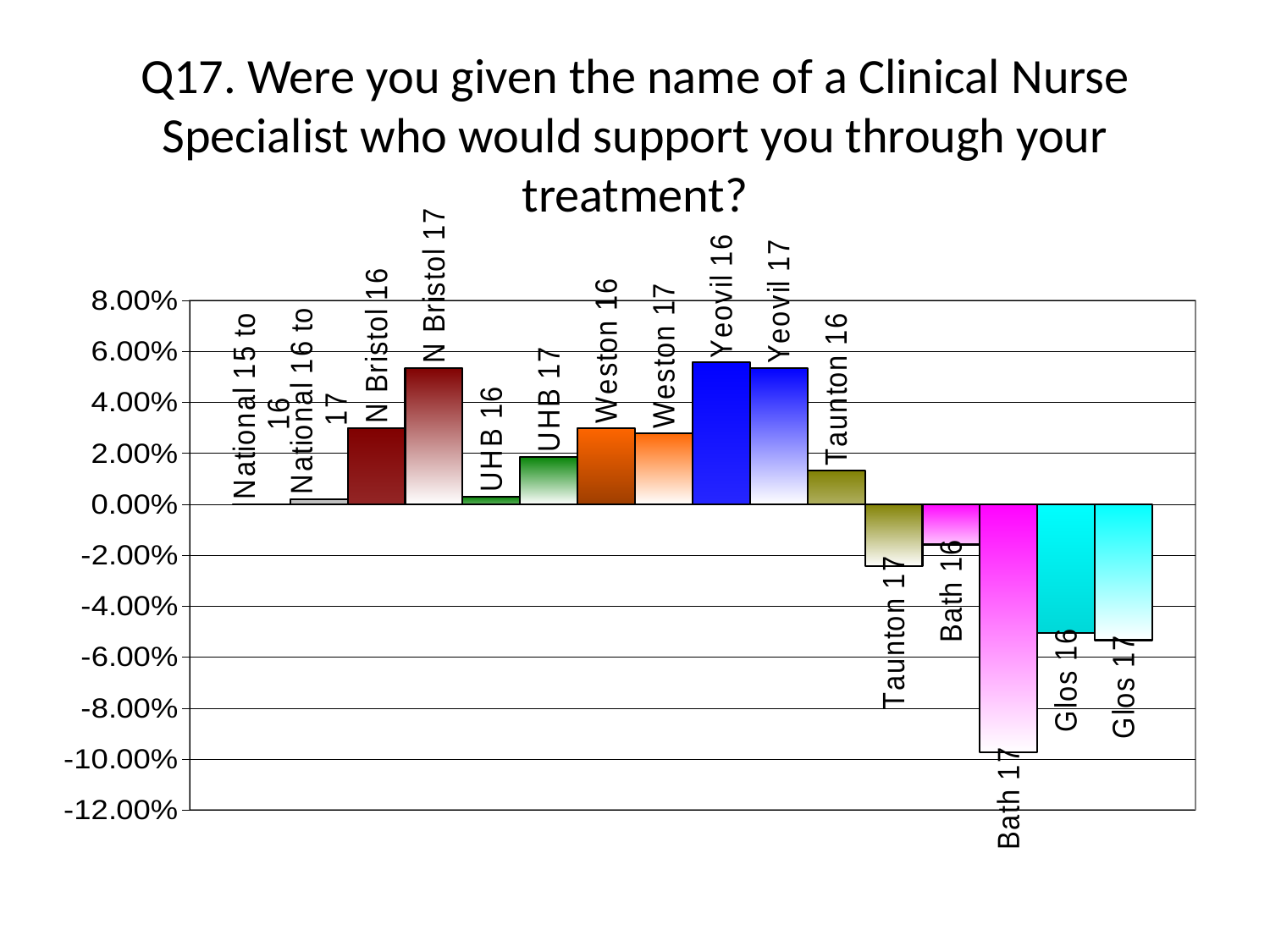
Which category has the lowest value in the chart? Bath 17 Which is larger, the value for Bath 17 or Glos 16? Glos 16 Which is larger, the value for N Bristol 16 or N Bristol 17? N Bristol 17 Which is larger, the value for Yeovil 16 or Taunton 16? Yeovil 16 What question number is referenced in the chart title? Q17 Is the value for N Bristol 17 greater or less than 4.00%? greater How many categories are plotted in the chart? 16 Is the value for Glos 16 greater or less than -4.00%? less Is the value for Taunton 17 greater or less than 0.00%? less What kind of chart is shown on the slide? bar chart